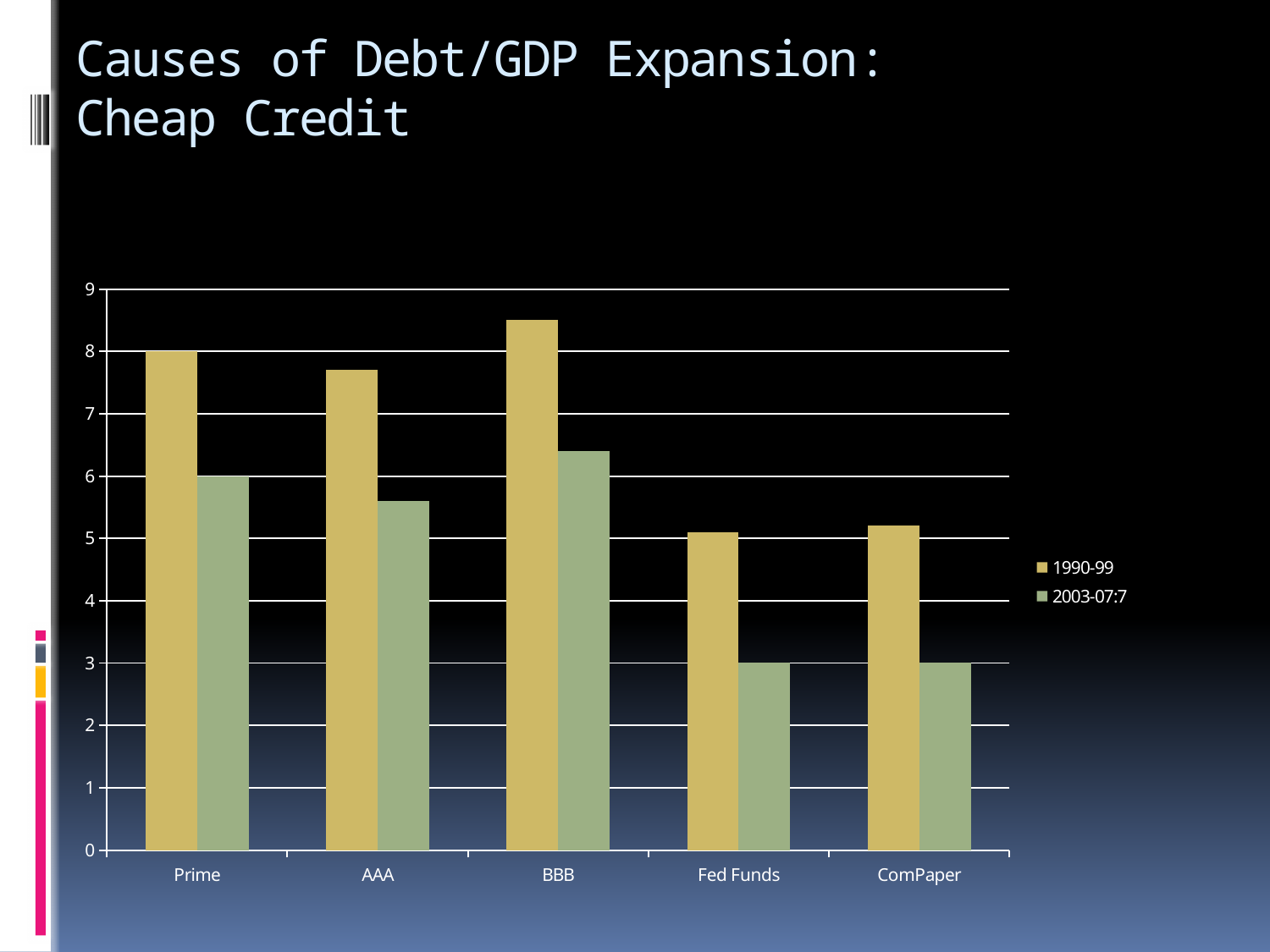
What is the value for Fed Funds in the 2003-07:7 series? 3 Is the value for AAA in the 1990-99 series greater or less than 7? greater Which category has the highest value in the 2003-07:7 series? BBB Which category has the highest value in the 1990-99 series? BBB How many categories are shown on the x axis? 5 What is the value for Prime in the 1990-99 series? 8 What type of chart is shown on the slide? bar chart Which is larger: the 1990-99 value for AAA or the 2003-07:7 value for BBB? 1990-99 value for AAA What is the difference between the 1990-99 and 2003-07:7 values for Prime? 2 How many series does the legend list? 2 What are the two series named in the legend? 1990-99 and 2003-07:7 What is the value for Prime in the 2003-07:7 series? 6